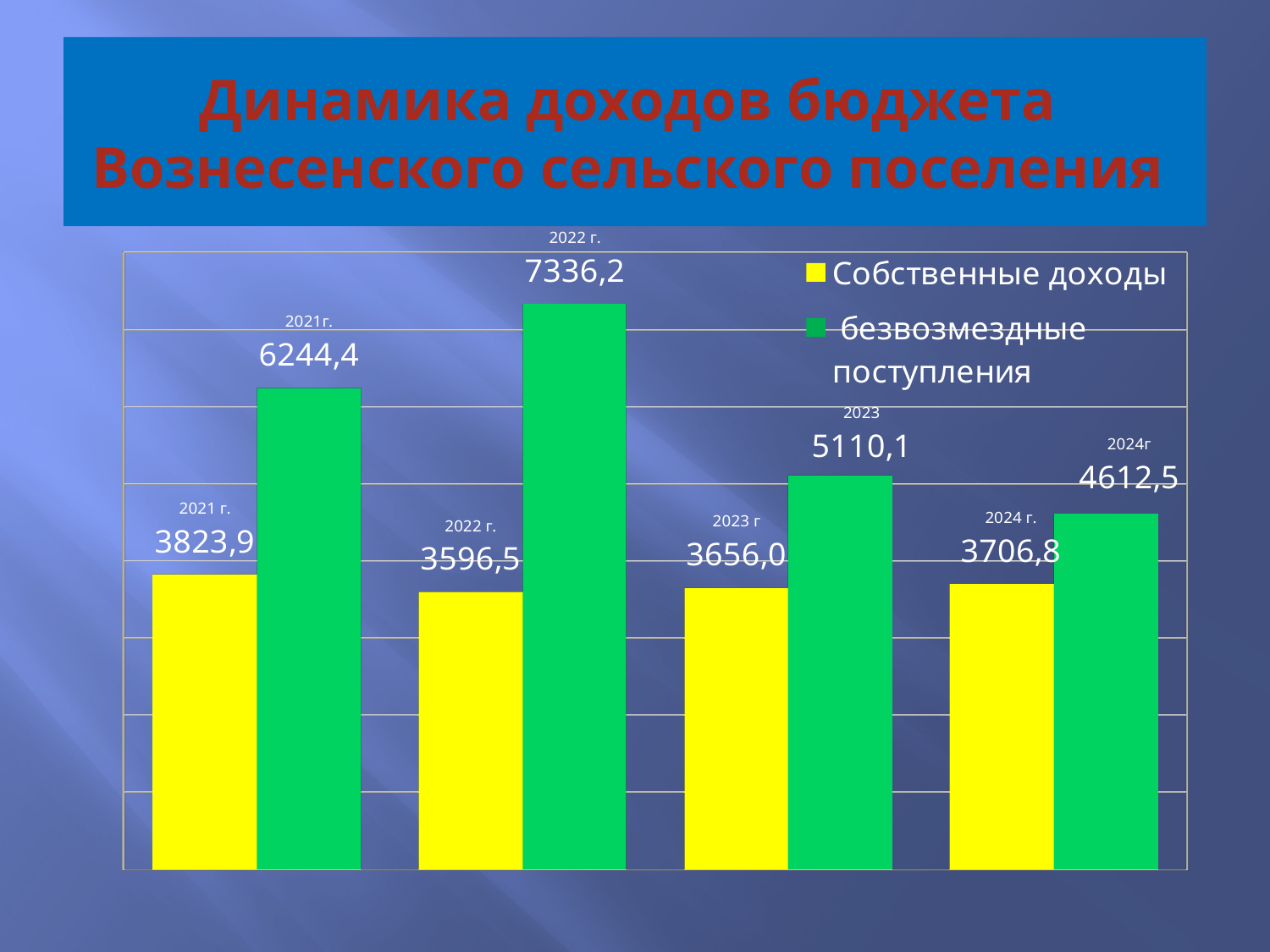
What is the value of безвозмездные поступления for 2023? 5110,1 In which year is Собственные доходы lowest? 2022 What kind of chart is shown on the slide? bar chart In which year is безвозмездные поступления highest? 2022 What is the value of Собственные доходы for 2021? 3823,9 Do the values of безвозмездные поступления rise or fall from 2022 to 2024? fall What is the difference between безвозмездные поступления in 2022 and in 2021? 1091,8 Which is larger in 2024: Собственные доходы or безвозмездные поступления? безвозмездные поступления How many series does the legend list? 2 What is the value of Собственные доходы for 2024? 3706,8 How many years are shown on the chart? 4 What is the value of безвозмездные поступления for 2022? 7336,2